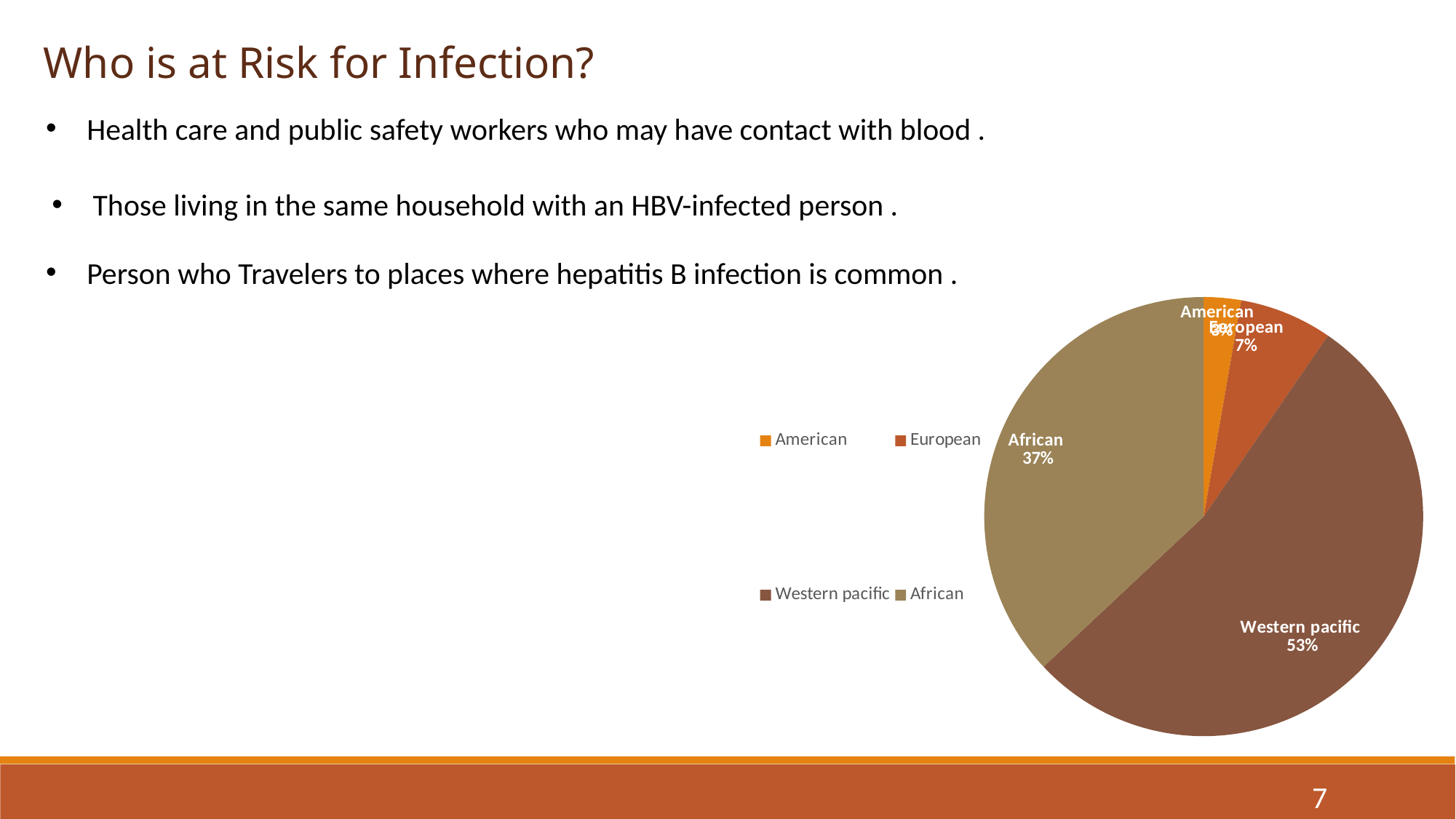
Which region has the smallest slice in the pie chart? American How many percentage points larger is the Western pacific slice than the African slice? 16% What share of the pie chart does Western pacific account for? 53% What type of chart is shown on the slide? Pie chart How many percentage points larger is the African slice than the European slice? 30% Which slice is larger, African or European? African Which region has the largest slice in the pie chart? Western pacific Which region is shown in the orange colour in the legend? American What percentage is shown for the African slice of the pie chart? 37% What percentage is shown for the European slice of the pie chart? 7% How many slices does the pie chart have? 4 How many entries does the chart legend list? 4